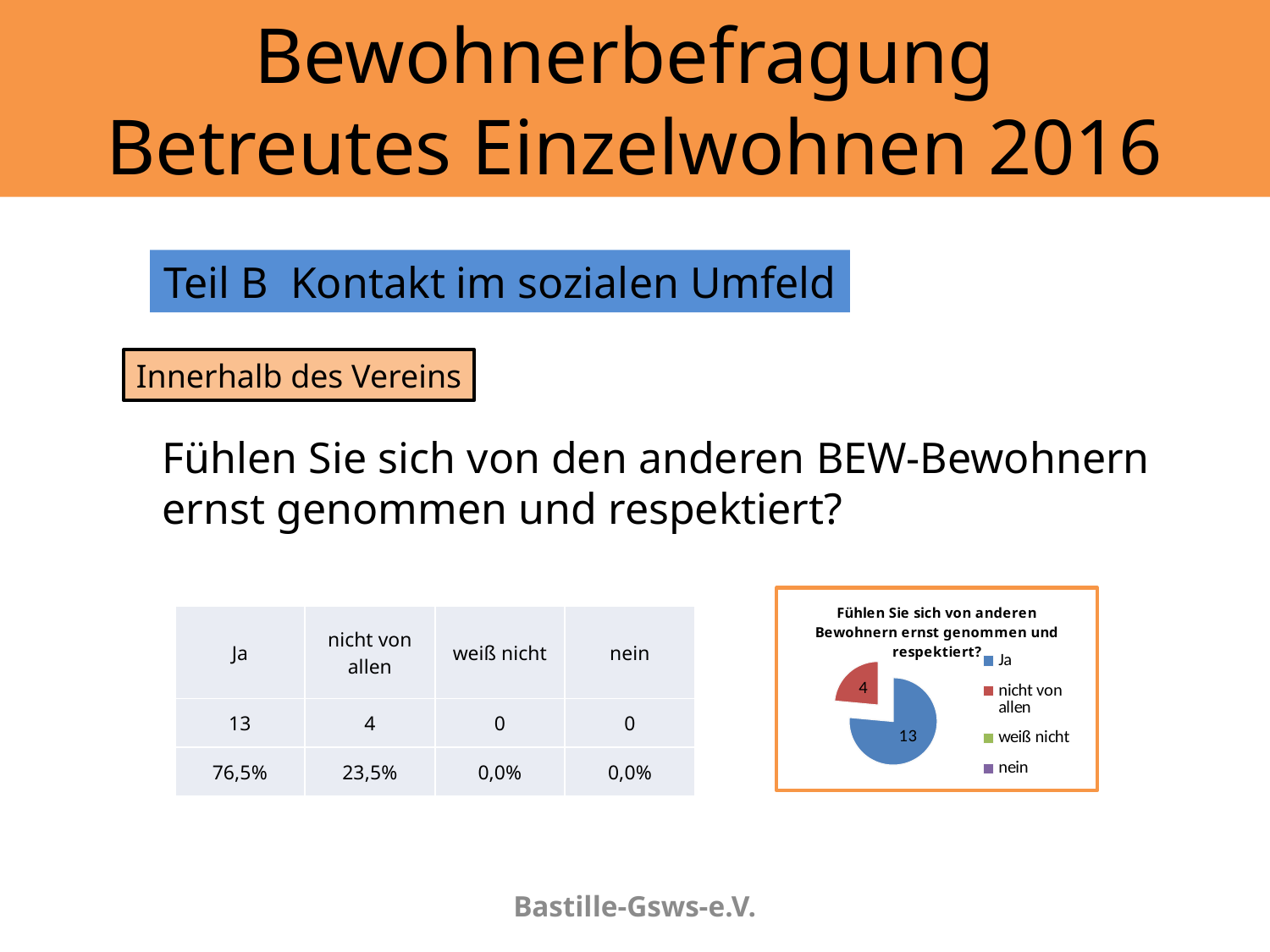
What share of the pie does the "nicht von allen" slice represent? 23,5% What is the difference between the values for "Ja" and "nicht von allen" in the pie chart? 9 In the pie chart, what is the value for "nicht von allen"? 4 What kind of chart is shown on the slide? pie chart Which category has the largest slice in the pie chart? Ja In the pie chart, what is the value for "Ja"? 13 Which legend entry of the pie chart is shown in red? nicht von allen What colour is the "Ja" slice in the pie chart? blue How many entries does the legend of the pie chart list? 4 Which is larger in the pie chart, "Ja" or "nicht von allen"? Ja What share of the pie does the "Ja" slice represent? 76,5% What is the total of the values shown as data labels in the pie chart? 17